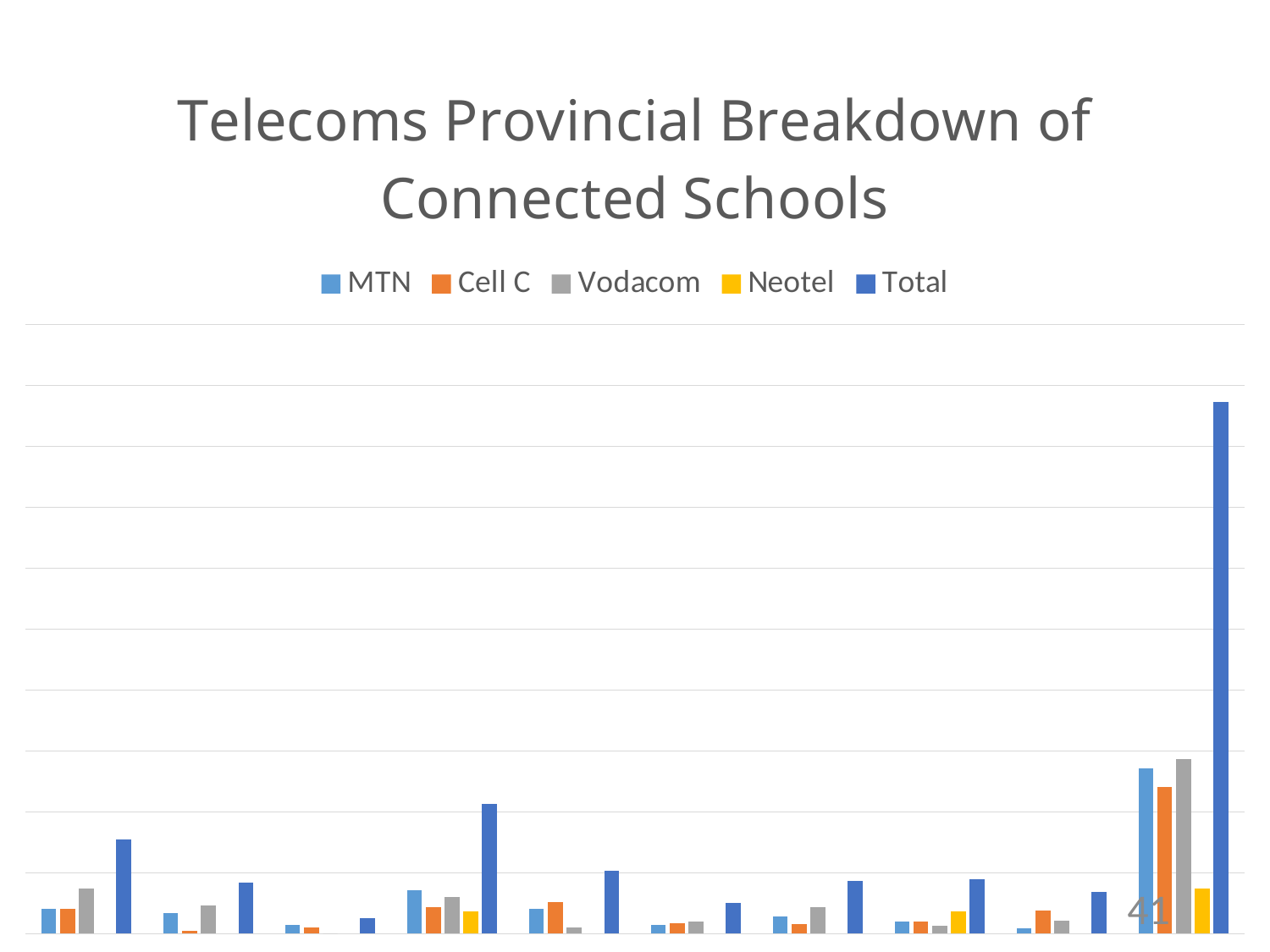
In the leftmost group of bars, which is taller, the Vodacom bar or the MTN bar? Vodacom Which group of bars has the tallest Total bar, the leftmost group or the rightmost group? the rightmost group How many series does the legend list? 5 How many groups of bars are plotted along the x axis? 10 Which series is shown in yellow in the legend? Neotel In the rightmost group of bars, which is taller, the Vodacom bar or the Cell C bar? Vodacom What kind of chart is shown on the slide? bar chart Which series has the tallest bar anywhere in the chart? Total What is the title of the chart? Telecoms Provincial Breakdown of Connected Schools In the rightmost group of bars, which series has the tallest bar? Total